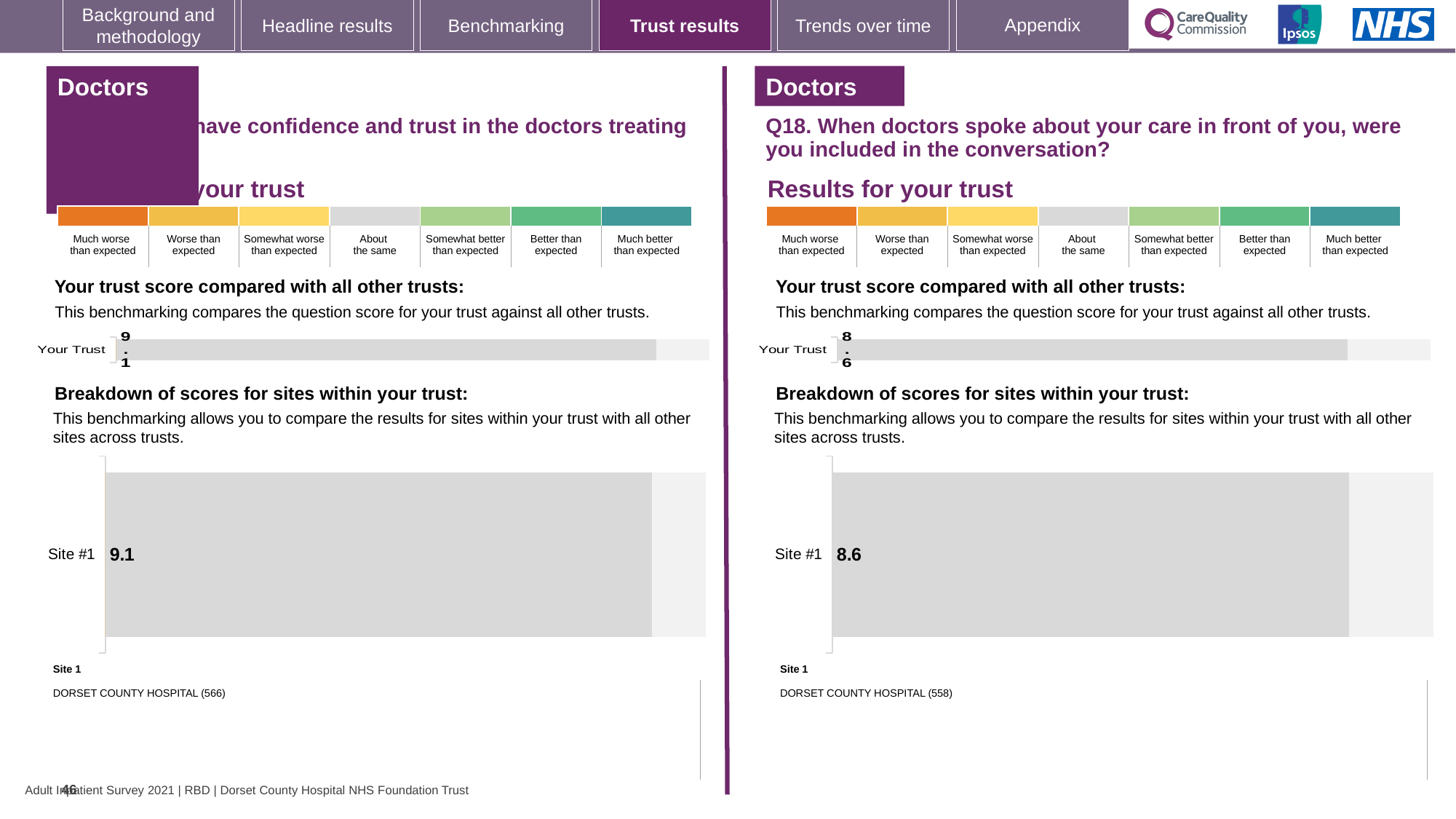
On the left-hand side of the slide, what is the score shown for Your Trust? 9.1 How many sites are shown in the Q18 breakdown of scores for sites within your trust? 1 In the Q18 breakdown of scores for sites within your trust, what is the score for Site #1? 8.6 What is the name of Site 1 listed under the left-hand breakdown chart? DORSET COUNTY HOSPITAL (566) Which is larger: the Your Trust score on the left-hand chart or the Your Trust score on the Q18 chart? The left-hand chart (9.1) In the left-hand breakdown of scores for sites within your trust, what is the score for Site #1? 9.1 Is the Site #1 score on the Q18 chart the same as the Your Trust score on the Q18 chart? Yes, both are 8.6 What is the name of Site 1 listed under the Q18 breakdown chart? DORSET COUNTY HOSPITAL (558) What is the difference between the Site #1 score on the left-hand chart and the Site #1 score on the Q18 chart? 0.5 What kind of chart is used to show the Site #1 score on the Q18 side of the slide? Bar chart On the right-hand side of the slide (Q18), what is the score shown for Your Trust? 8.6